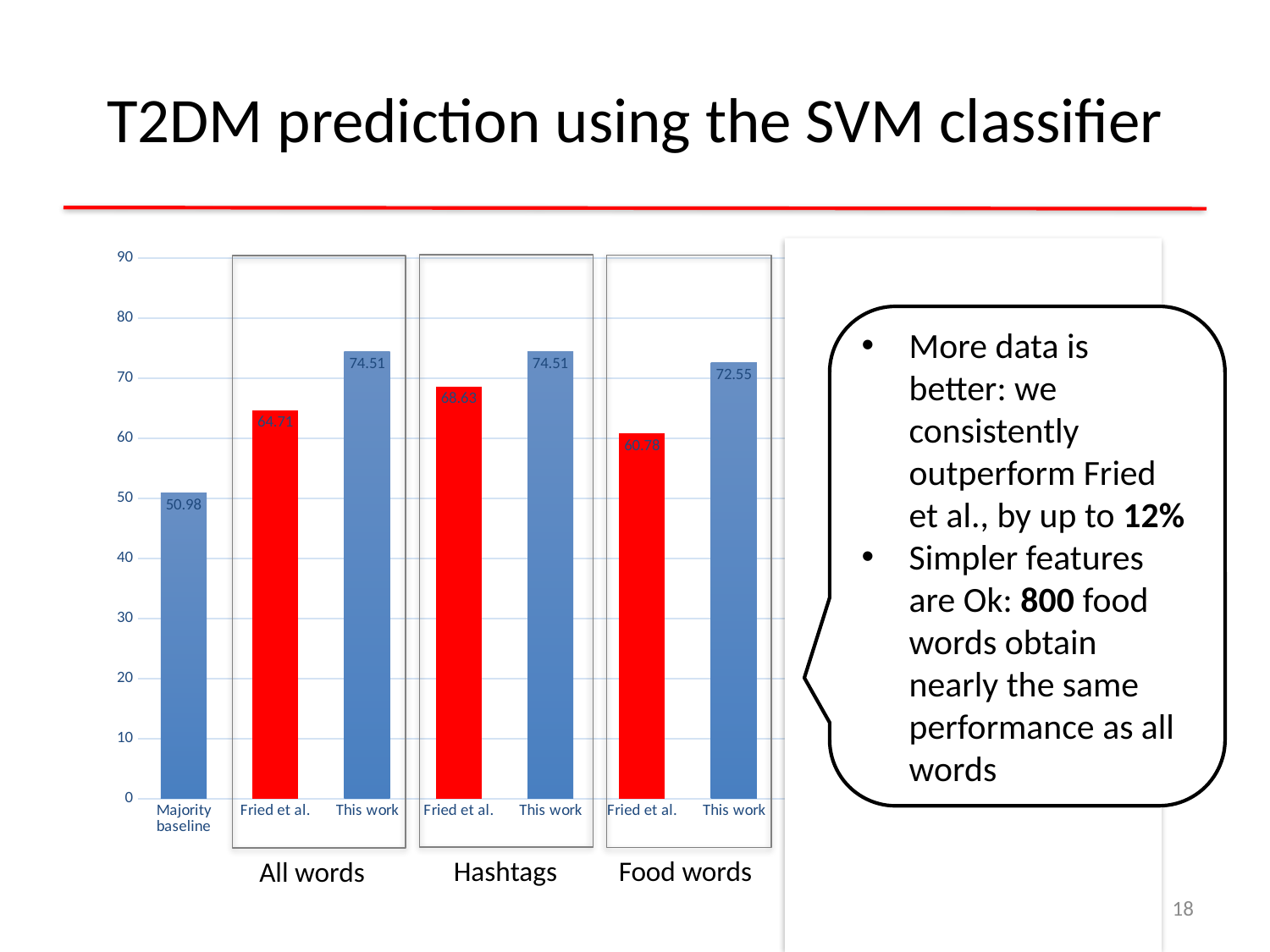
What kind of chart is shown on the slide? Bar chart What is the value for This work in the All words group? 74.51 Is the value for This work in the Hashtags group greater or less than 70? greater What is the difference between This work and Fried et al. in the All words group? 9.80 Which bar has the lowest value on the chart? Majority baseline Which is larger: Fried et al. in the Hashtags group or Fried et al. in the Food words group? Fried et al. in the Hashtags group What is the difference between This work and Fried et al. in the Food words group? 11.77 How many bars are plotted on the chart? 7 What is the value for This work in the Food words group? 72.55 What is the value for Fried et al. in the Hashtags group? 68.63 What is the value of the Majority baseline bar? 50.98 What is the value for Fried et al. in the Food words group? 60.78